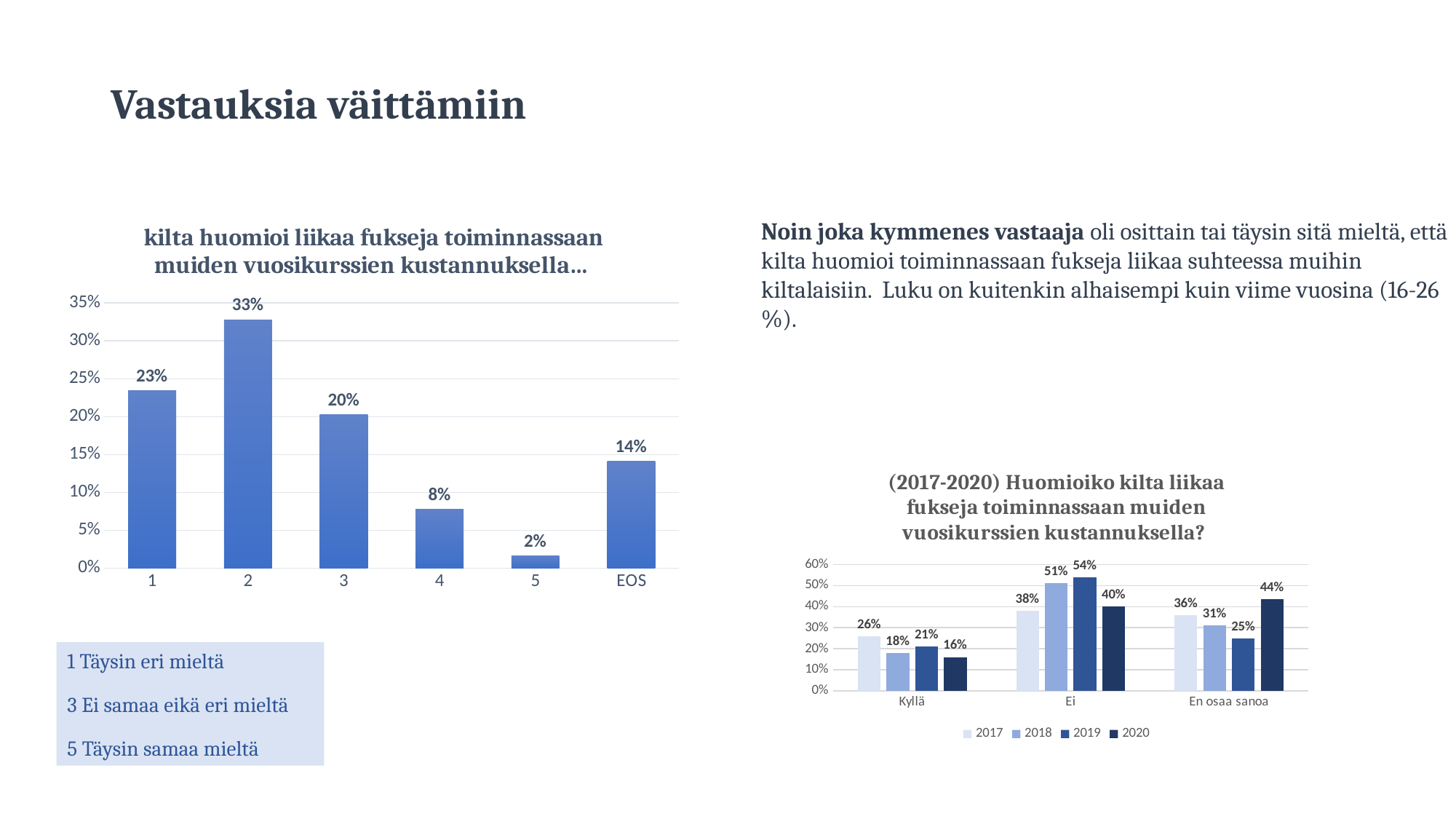
In the right chart (2017-2020), which is larger for En osaa sanoa: 2017 or 2020? 2020 What kind of chart is the left chart? bar chart In the right chart (2017-2020), do the Kyllä values rise or fall from 2017 to 2020? fall In the left chart, how many categories are shown on the x axis? 6 In the left chart, which category has the highest value? 2 In the left chart, which category has the lowest value? 5 In the left chart, what is the difference between the values for category 1 and category 3? 3% In the left chart, what is the value for EOS? 14% In the right chart (2017-2020), what is the value for 2019 in the Ei category? 54% In the right chart (2017-2020), how many series does the legend list? 4 In the left chart, what is the value for category 2? 33% In the right chart (2017-2020), what is the difference between the 2017 and 2020 values in the Kyllä category? 10%